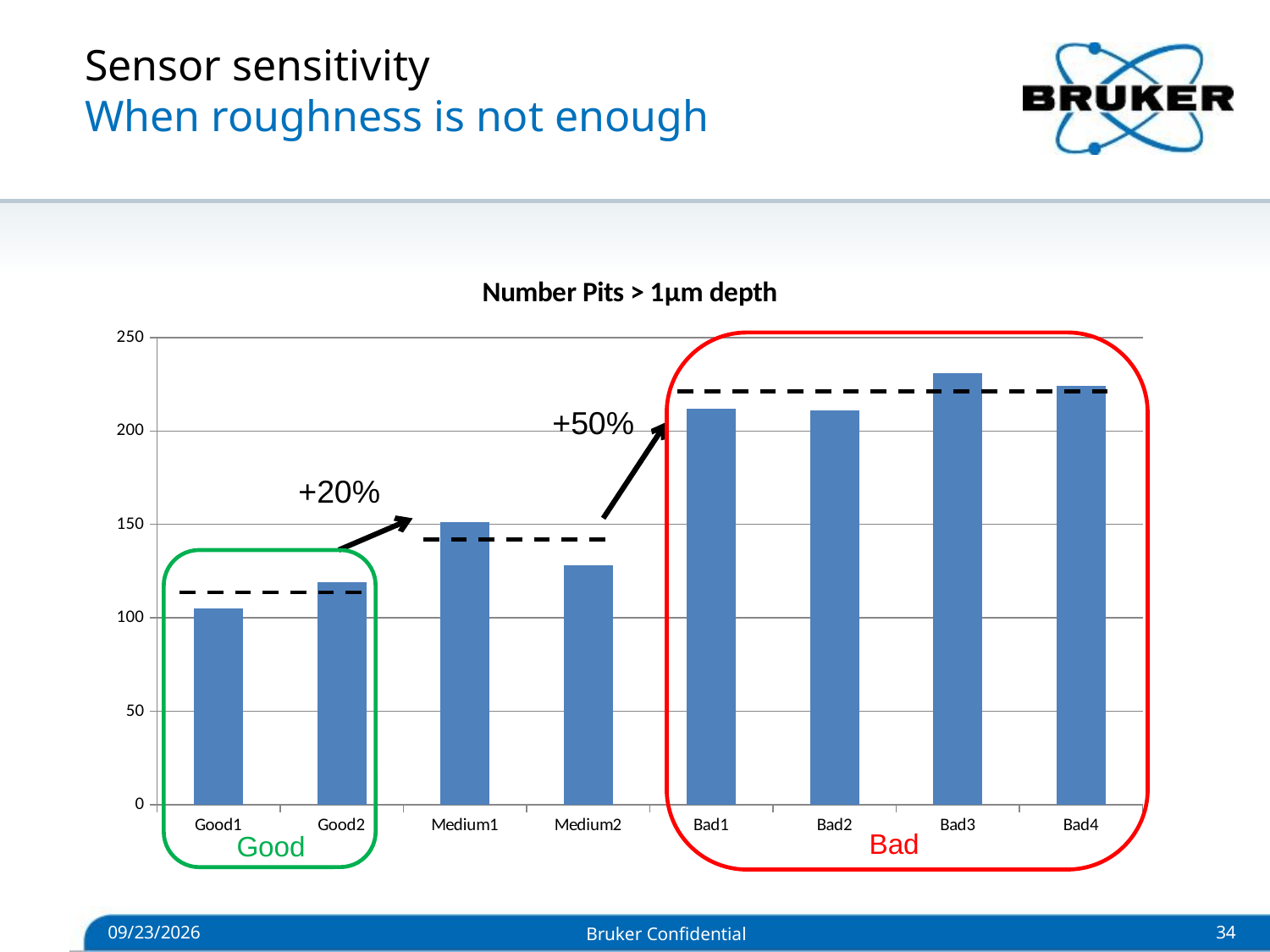
Is the value for Good1 greater or less than 100? greater Is the value for Good2 greater or less than 150? less What percentage increase is annotated between the Medium group and the Bad group? +50% How many categories are plotted on the x axis of the chart? 8 Which category has the lowest bar in the chart? Good1 What is the title of the chart? Number Pits > 1µm depth Is the value for Medium2 greater or less than 150? less Which has the larger value, Medium1 or Medium2? Medium1 What kind of chart is shown on the slide? bar chart Which category has the highest bar in the chart? Bad3 Which has the larger value, Good2 or Bad4? Bad4